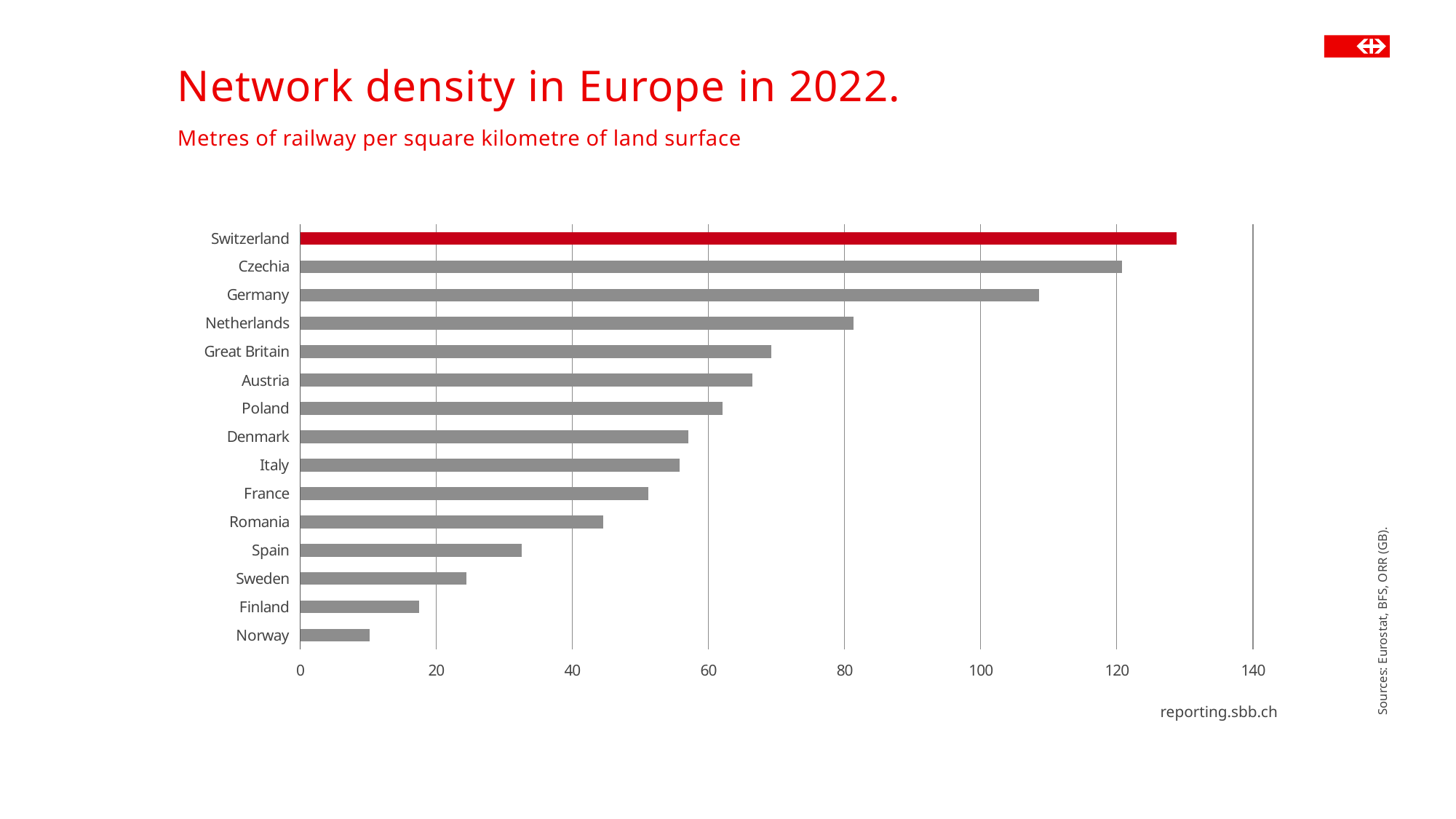
Which country has the highest network density in the chart? Switzerland Which country has the lowest network density in the chart? Norway Which has the larger value, Spain or Romania? Romania Is the value for Switzerland greater or less than 120? greater How many countries are shown in the chart? 15 Is the value for Czechia greater or less than 100? greater What kind of chart is shown on the slide? bar chart Are the bars ordered from highest to lowest or from lowest to highest going down the chart? highest to lowest Is the value for Norway greater or less than 20? less Which has the larger value, Germany or the Netherlands? Germany Which country's bar is highlighted in red? Switzerland